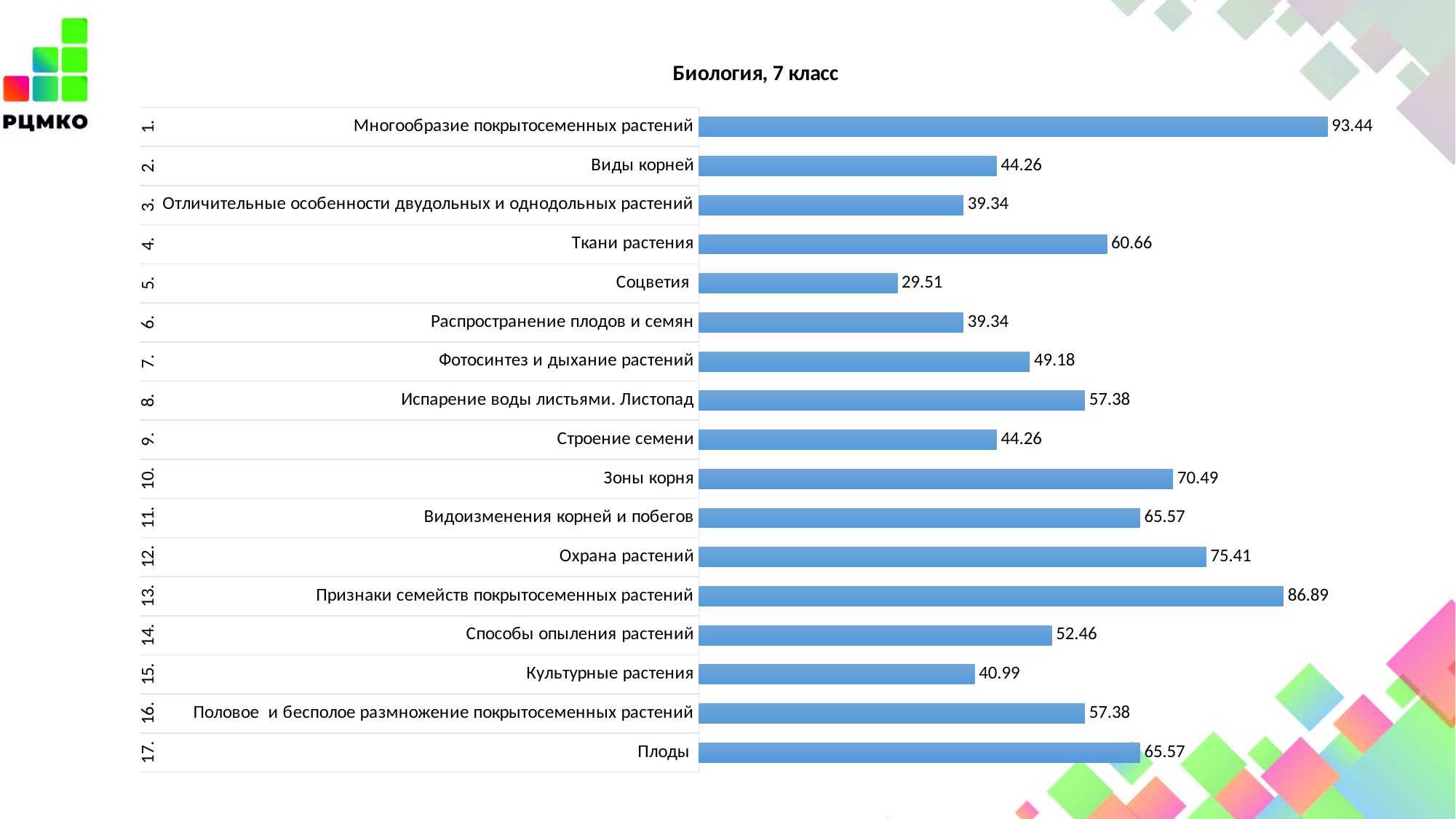
What type of chart is shown on the slide? bar chart What is the value for "Способы опыления растений"? 52.46 What is the difference between the values for "Многообразие покрытосеменных растений" and "Соцветия"? 63.93 What is the title of the chart? Биология, 7 класс What is the value for "Ткани растения"? 60.66 What is the value for "Зоны корня"? 70.49 How many categories (topics) are plotted in the chart? 17 Which topic has the highest value? Многообразие покрытосеменных растений What is the difference between the values for "Ткани растения" and "Культурные растения"? 19.67 Which topic has the lowest value? Соцветия What is the value for "Культурные растения"? 40.99 Which is larger: the value for "Охрана растений" or the value for "Зоны корня"? Охрана растений